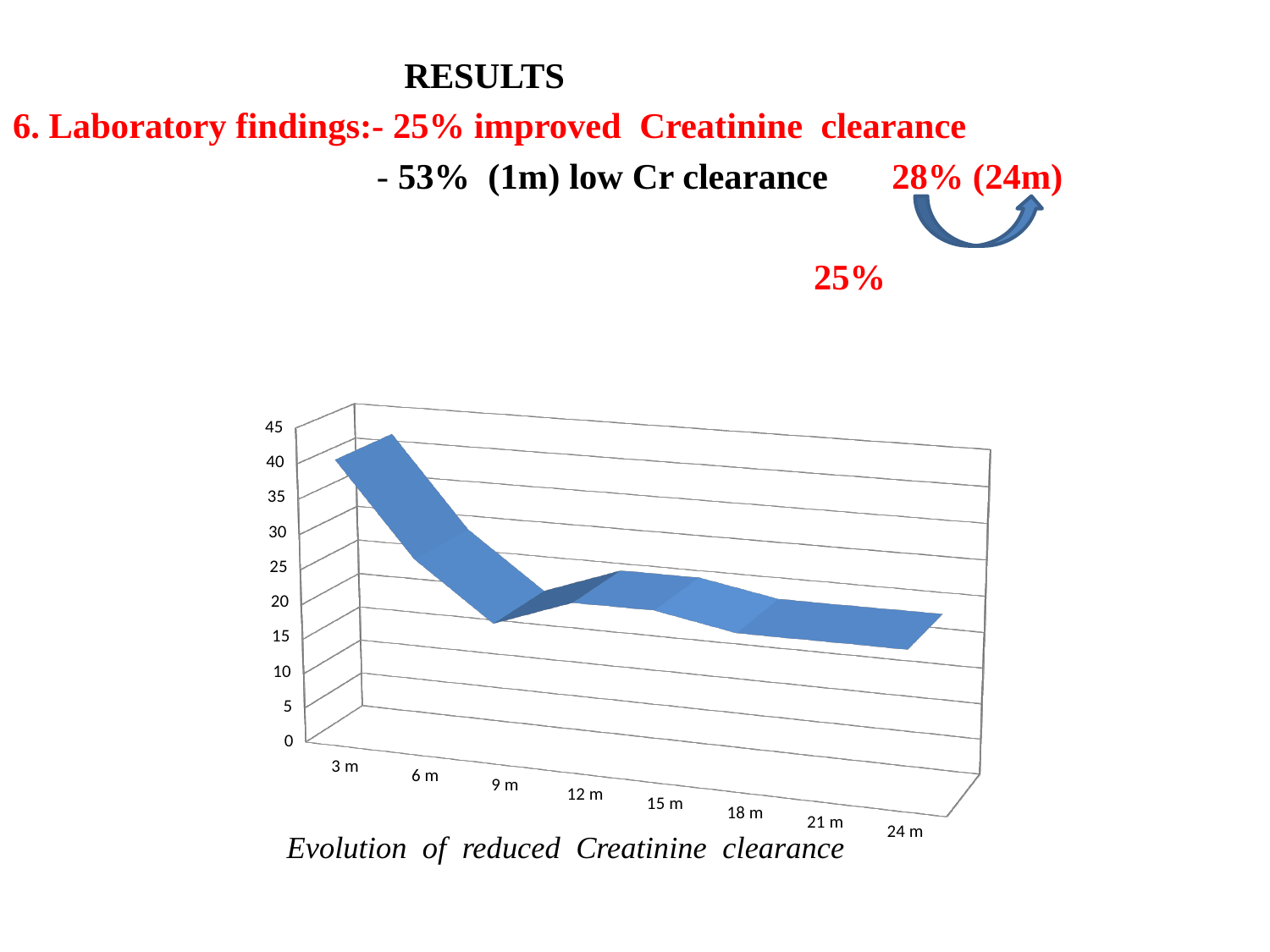
How many time points are plotted along the x axis of the chart? 8 Do the values in the chart generally rise or fall from 3 m to 24 m? fall Is the value at 3 m greater or less than 30? greater What is the caption written below the chart? Evolution of reduced Creatinine clearance Is the value at 12 m greater or less than 30? less What kind of chart is shown on the slide? 3D line chart What is the highest tick value shown on the vertical axis of the chart? 45 Which is larger, the value at 6 m or the value at 24 m? 6 m Which time point has the highest value in the chart? 3 m Is the value at 9 m greater or less than 35? less Which is larger, the value at 3 m or the value at 18 m? 3 m